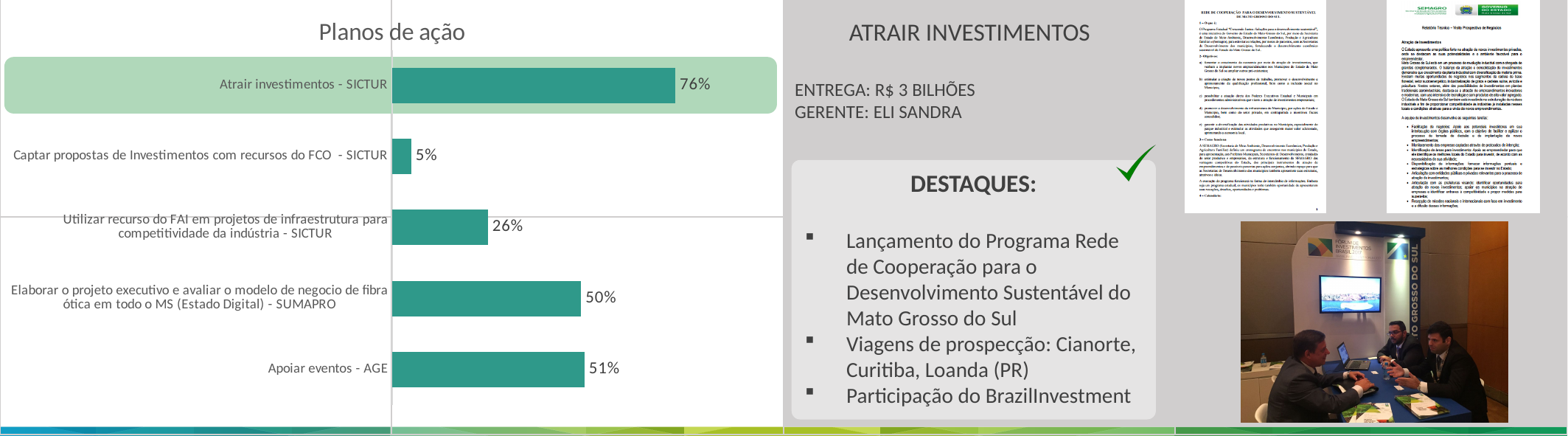
Which category has the lowest value in the Planos de ação chart? Captar propostas de Investimentos com recursos do FCO - SICTUR What is the value for "Captar propostas de Investimentos com recursos do FCO - SICTUR"? 5% What is the value for "Utilizar recurso do FAI em projetos de infraestrutura para competitividade da indústria - SICTUR"? 26% What is the difference between the values for "Atrair investimentos - SICTUR" and "Apoiar eventos - AGE"? 25% What is the value for "Atrair investimentos - SICTUR" in the Planos de ação chart? 76% Which category has the highest value in the Planos de ação chart? Atrair investimentos - SICTUR What is the value for "Apoiar eventos - AGE"? 51% What kind of chart is the Planos de ação chart? Bar chart Which is larger: the value for "Elaborar o projeto executivo e avaliar o modelo de negocio de fibra ótica em todo o MS (Estado Digital) - SUMAPRO" or for "Utilizar recurso do FAI em projetos de infraestrutura para competitividade da indústria - SICTUR"? Elaborar o projeto executivo e avaliar o modelo de negocio de fibra ótica em todo o MS (Estado Digital) - SUMAPRO What is the difference between the values for "Apoiar eventos - AGE" and "Elaborar o projeto executivo e avaliar o modelo de negocio de fibra ótica em todo o MS (Estado Digital) - SUMAPRO"? 1% What is the title of the chart on the slide? Planos de ação How many categories are shown in the Planos de ação chart? 5